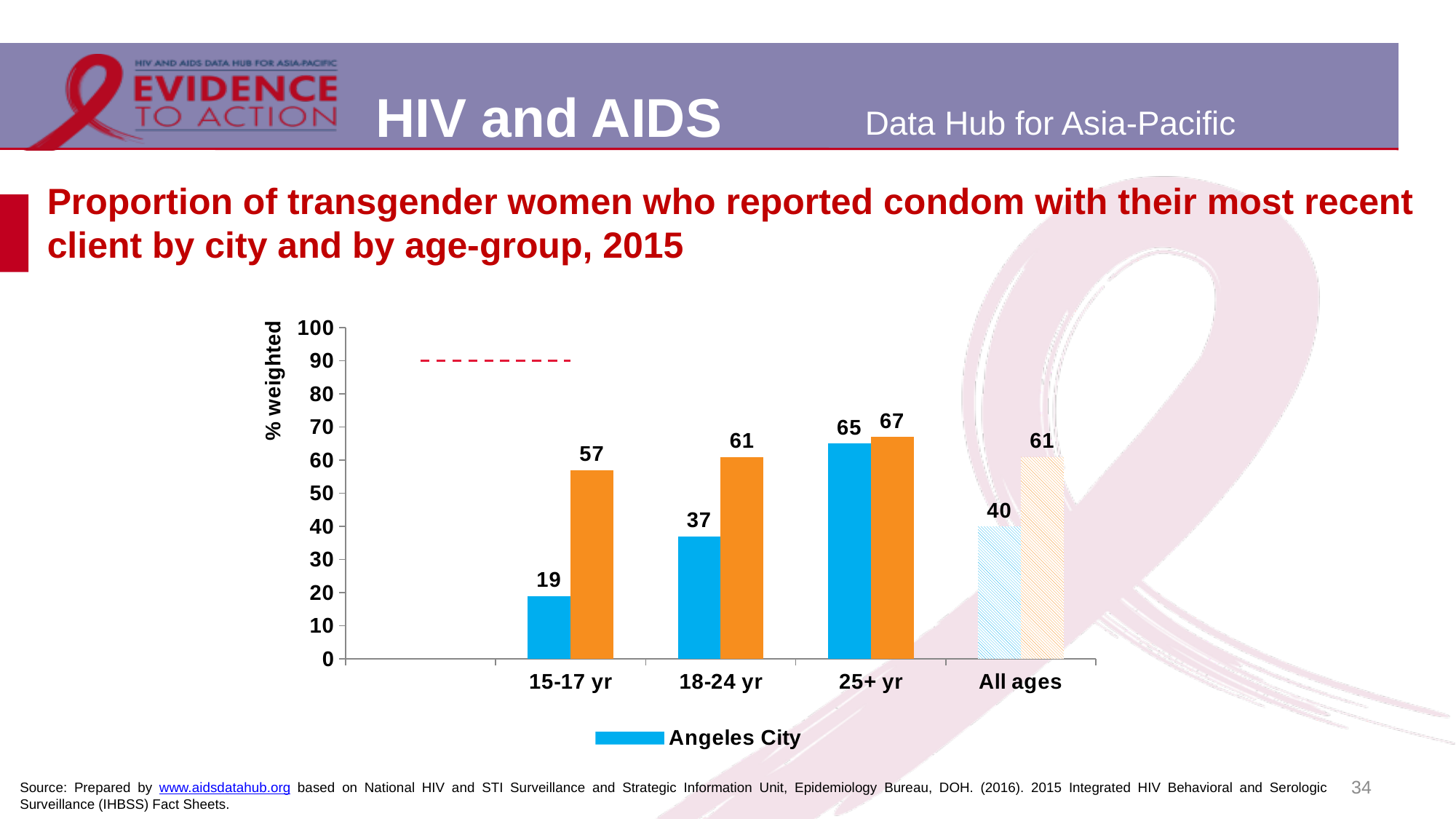
Which is larger for Angeles City: the 18-24 yr value or the All ages value? All ages What is the value for Angeles City in the 15-17 yr age group? 19 What kind of chart is shown on the slide? Bar chart What is the difference between the Angeles City values for 25+ yr and 15-17 yr? 46 Which age group has the highest value for Angeles City? 25+ yr What is the value of the orange bar in the 15-17 yr age group? 57 Which age group has the lowest value for Angeles City? 15-17 yr What is the value for Angeles City in the 25+ yr age group? 65 How many series does the legend list? 1 Do the Angeles City values rise or fall from 15-17 yr to 25+ yr? Rise How many age-group categories are shown on the x axis? 4 What is the value for Angeles City for All ages? 40